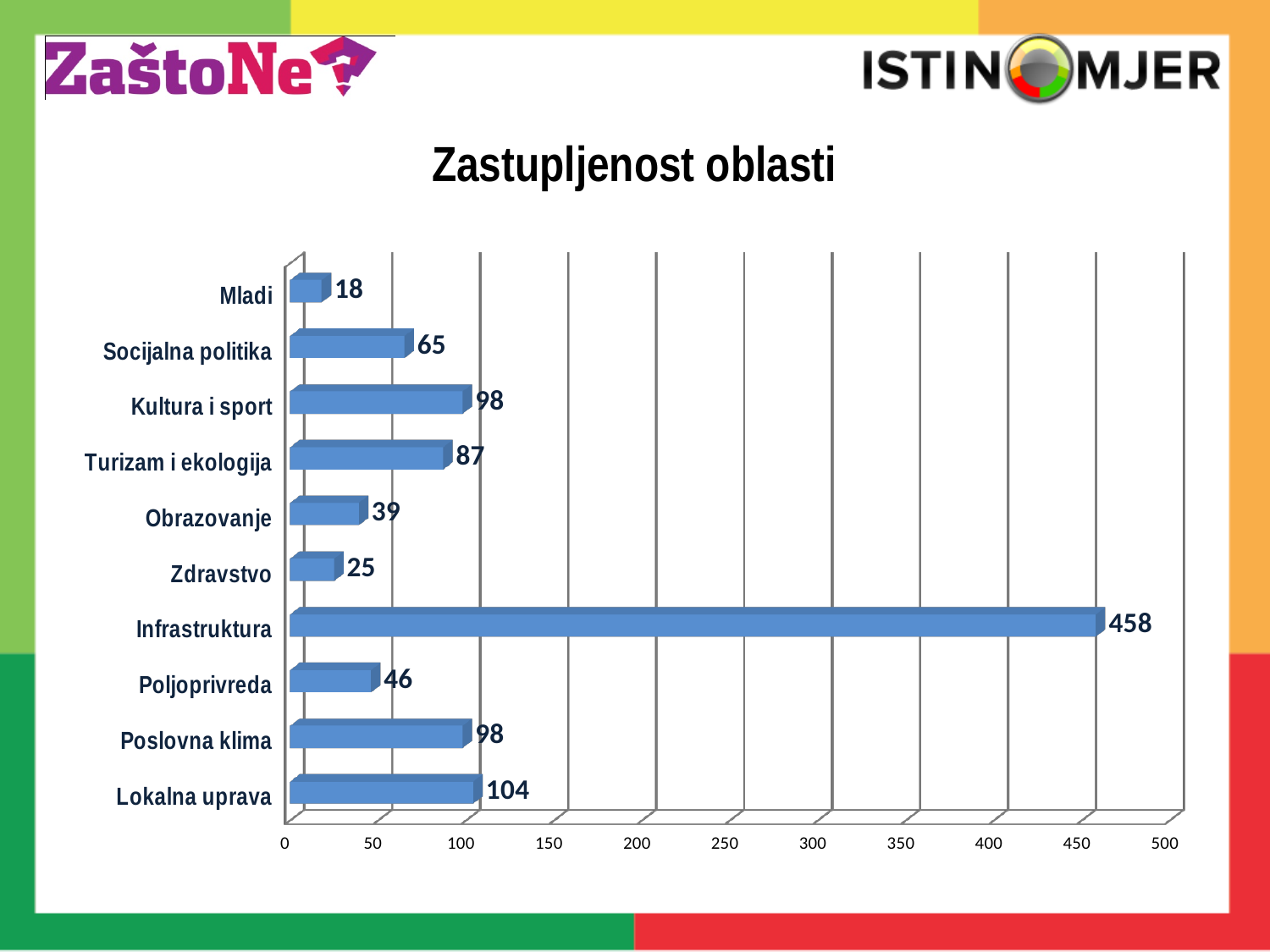
Which category has the highest value? Infrastruktura Is the value for Infrastruktura greater or less than 400? greater What is the value for Infrastruktura? 458 What is the title of the chart? Zastupljenost oblasti What is the difference between the values for Socijalna politika and Zdravstvo? 40 What is the difference between the values for Infrastruktura and Lokalna uprava? 354 Which is larger, the value for Obrazovanje or the value for Poljoprivreda? Poljoprivreda What kind of chart is shown on the slide? bar chart What is the value for Turizam i ekologija? 87 What is the value for Lokalna uprava? 104 How many categories are shown in the chart? 10 Which category has the lowest value? Mladi